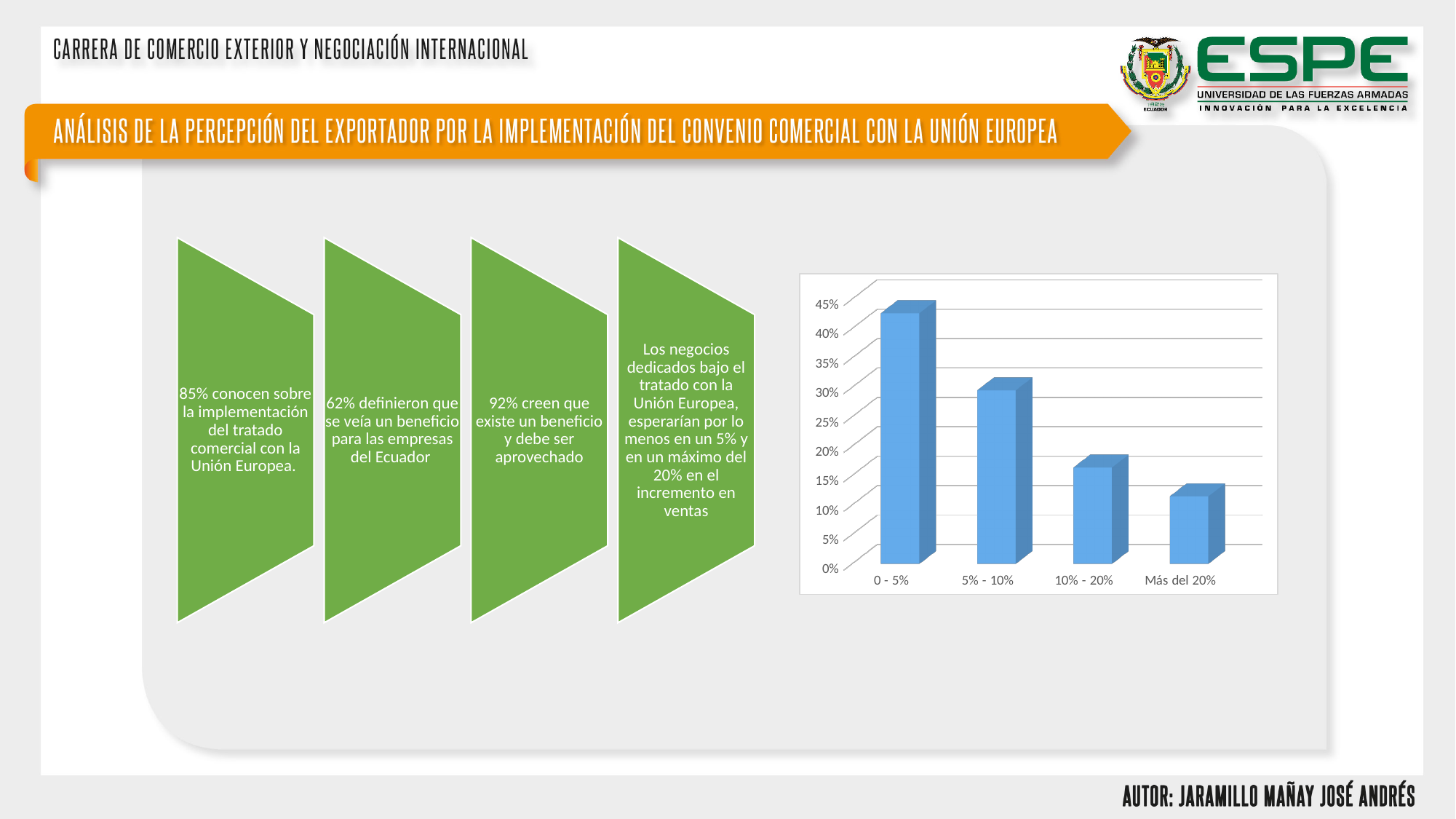
What kind of chart is shown on the slide? bar chart Which is larger, the value for 0 - 5% or the value for Más del 20%? 0 - 5% Do the bar values rise or fall from left to right along the x axis? fall Is the value for 10% - 20% greater or less than 20%? less Which is larger, the value for 5% - 10% or the value for 10% - 20%? 5% - 10% How many categories are shown on the x axis of the chart? 4 Is the value for Más del 20% greater or less than 15%? less Which category has the highest bar in the chart? 0 - 5% Which category has the lowest bar in the chart? Más del 20% Is the value for 0 - 5% greater or less than 40%? greater What is the highest value shown on the chart's vertical axis? 45%